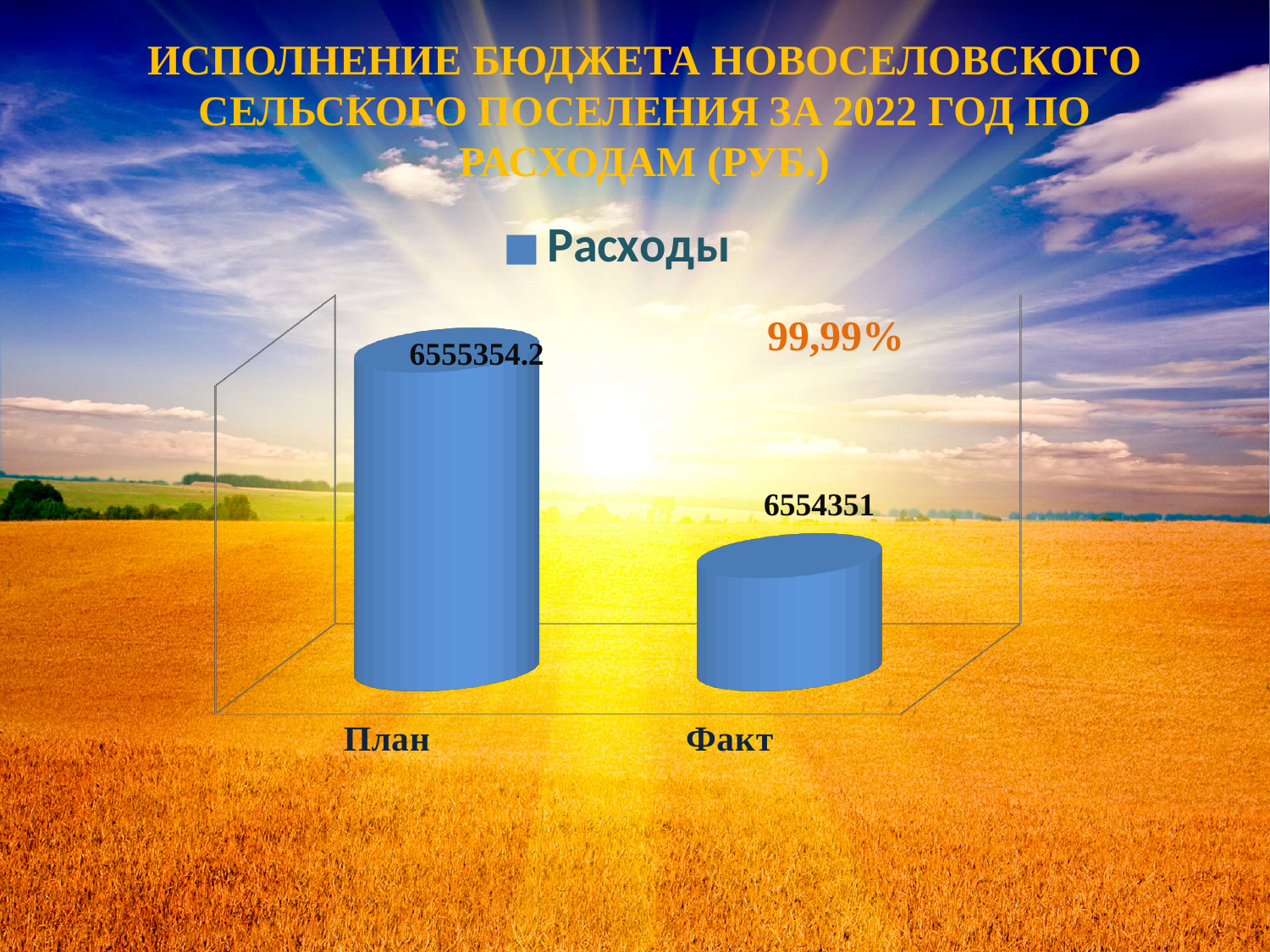
What is the value for Факт? 6554351 What is the value for План? 6555354.2 What series name is shown in the chart legend? Расходы What percentage is printed on the slide next to the chart? 99,99% What kind of chart is shown on the slide? Bar chart Which is larger, the value for План or the value for Факт? План How many series does the legend list? 1 What is the difference between the values for План and Факт? 1003.2 Which category has the highest value? План Do the values rise or fall from План to Факт? Fall How many categories are shown on the chart? 2 Which category has the lowest value? Факт